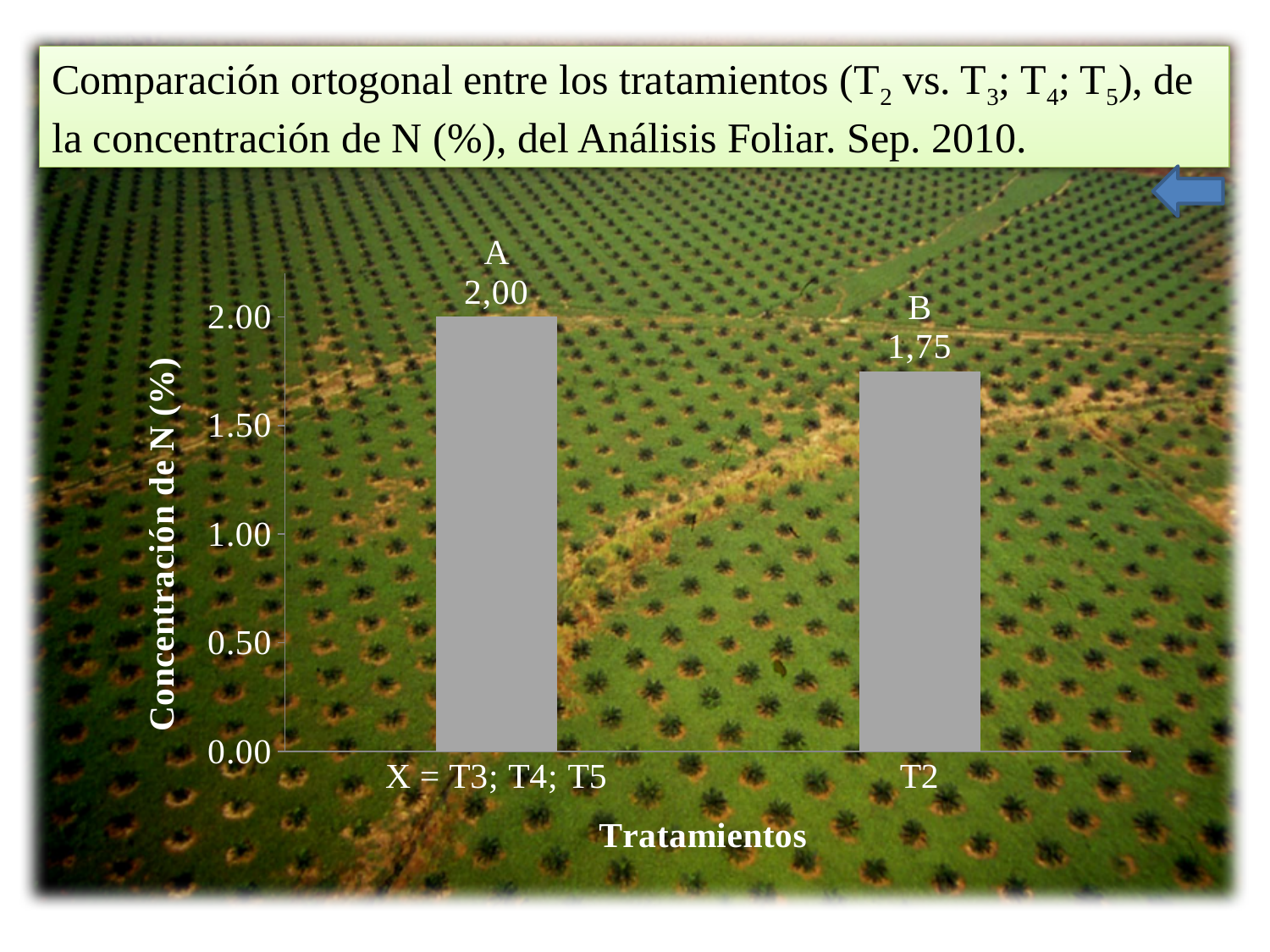
How many categories are plotted on the x axis? 2 What is the N concentration value shown for T2? 1,75 Is the value for T2 greater or less than 1.50? greater Which category has the higher N concentration? X = T3; T4; T5 What kind of chart is shown on the slide? bar chart What is the difference between the N concentration for 'X = T3; T4; T5' and for T2? 0,25 What is the label on the y axis of the chart? Concentración de N (%) Which statistical group letter is shown above the T2 bar? B Which category has the lower N concentration? T2 What is the label on the x axis of the chart? Tratamientos Is the value for 'X = T3; T4; T5' larger or smaller than the value for T2? larger What is the N concentration value shown for the category 'X = T3; T4; T5'? 2,00